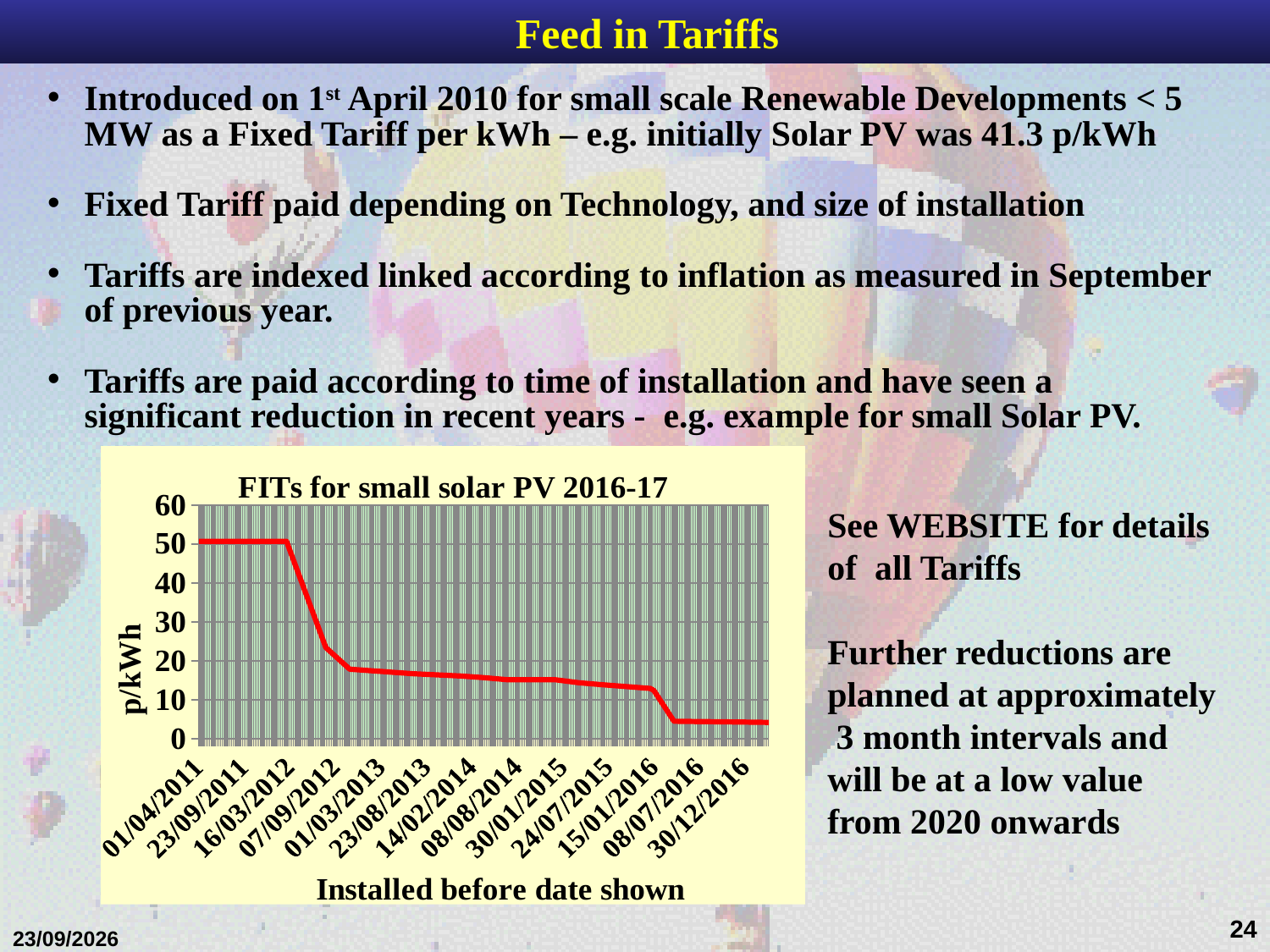
What is the label of the vertical axis of the chart? p/kWh Do the values in the chart rise or fall as you move from left to right along the x axis? fall How many date labels are shown along the x axis of the chart? 13 What kind of chart is shown on the slide? line chart What is the title of the chart on the slide? FITs for small solar PV 2016-17 Is the value for 01/04/2011 greater or less than 40? greater Is the value for 01/03/2013 greater or less than 30? less Is the value for 24/07/2015 greater or less than 10? greater What is the highest value shown on the vertical axis of the chart? 60 Which date has the higher value, 23/09/2011 or 08/08/2014? 23/09/2011 Which date has the lower value, 15/01/2016 or 30/12/2016? 30/12/2016